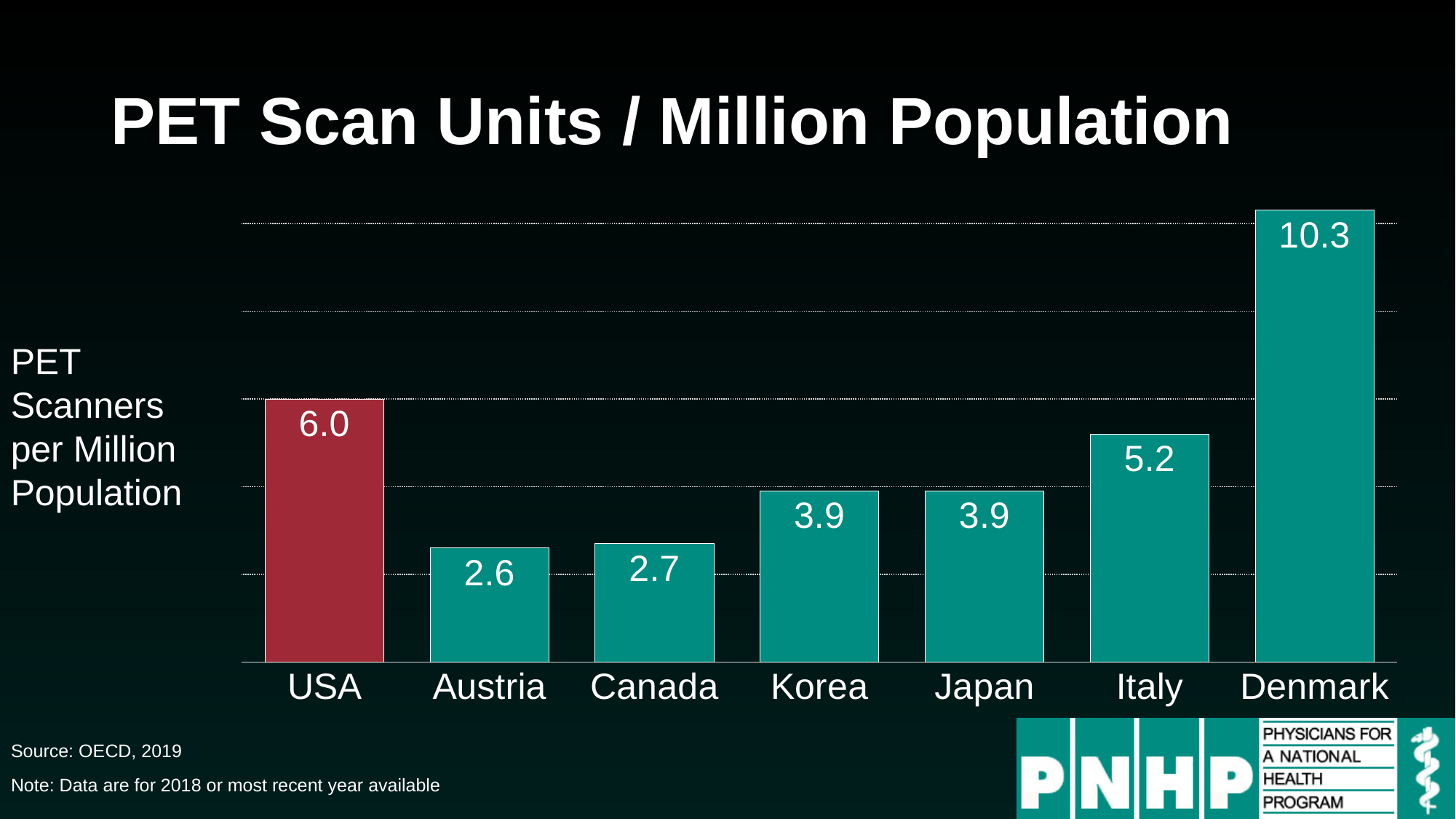
What is the difference between the values for Denmark and the USA? 4.3 What kind of chart is shown on the slide? Bar chart How many countries are shown in the chart? 7 What is the value for Denmark? 10.3 Which has a larger value, Italy or Japan? Italy Which country has the highest number of PET scanners per million population? Denmark What is the value for Austria? 2.6 What is the value for Italy? 5.2 What is the difference between the values for Canada and Austria? 0.1 Which bar is shown in a different colour (red) from the others? USA What is the value for the USA? 6.0 Which country has the lowest number of PET scanners per million population? Austria